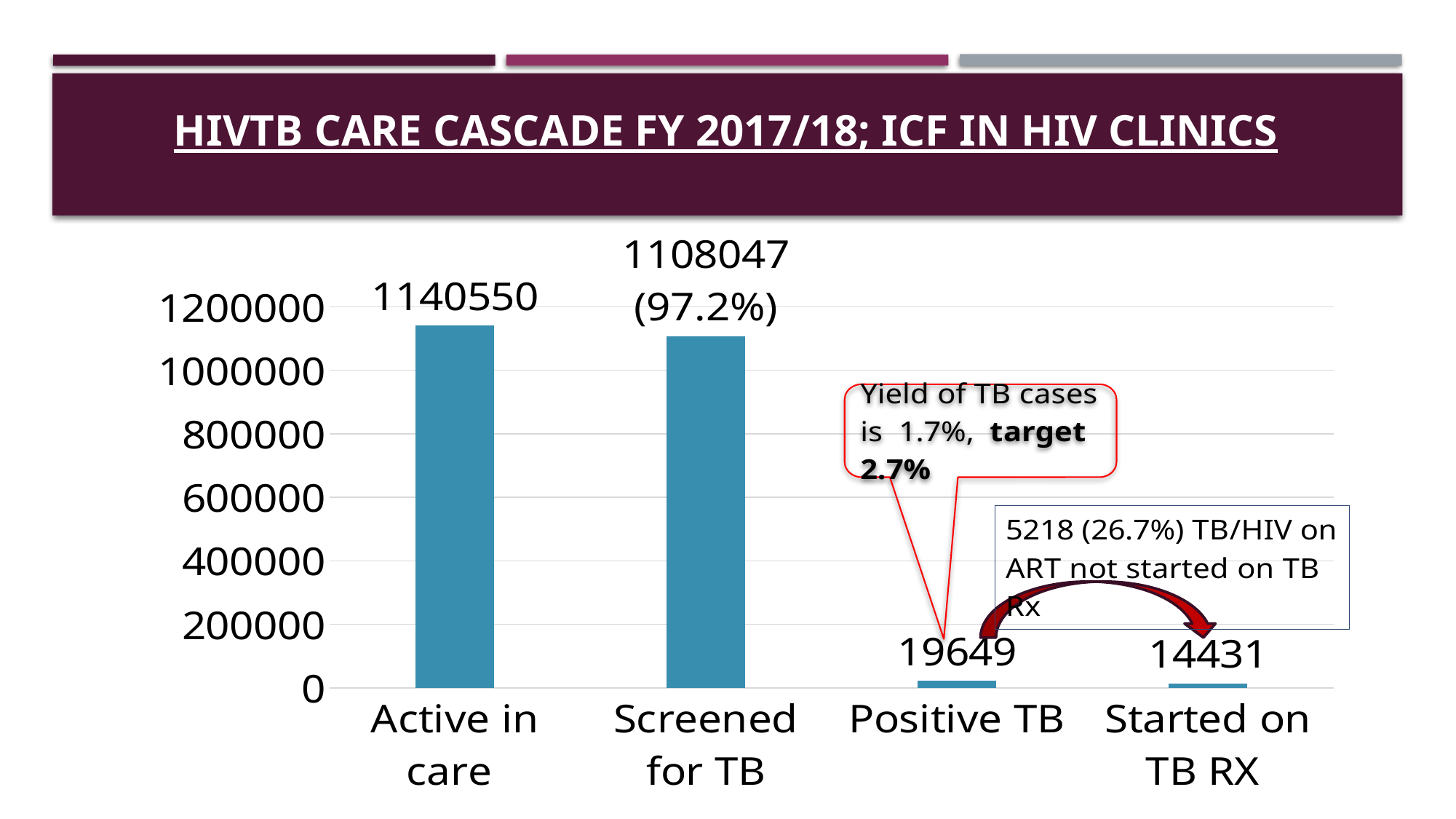
What kind of chart is this? Bar chart Which category has the highest value? Active in care What is the difference between Positive TB and Started on TB RX? 5218 Which is larger, Positive TB or Started on TB RX? Positive TB What is the value for Positive TB? 19649 How many categories are shown on the x axis? 4 What is the value for Screened for TB? 1108047 What is the value for Started on TB RX? 14431 Which category has the lowest value? Started on TB RX What is the value for Active in care? 1140550 Do the values rise or fall from left to right along the x axis? Fall What is the difference between Active in care and Screened for TB? 32503